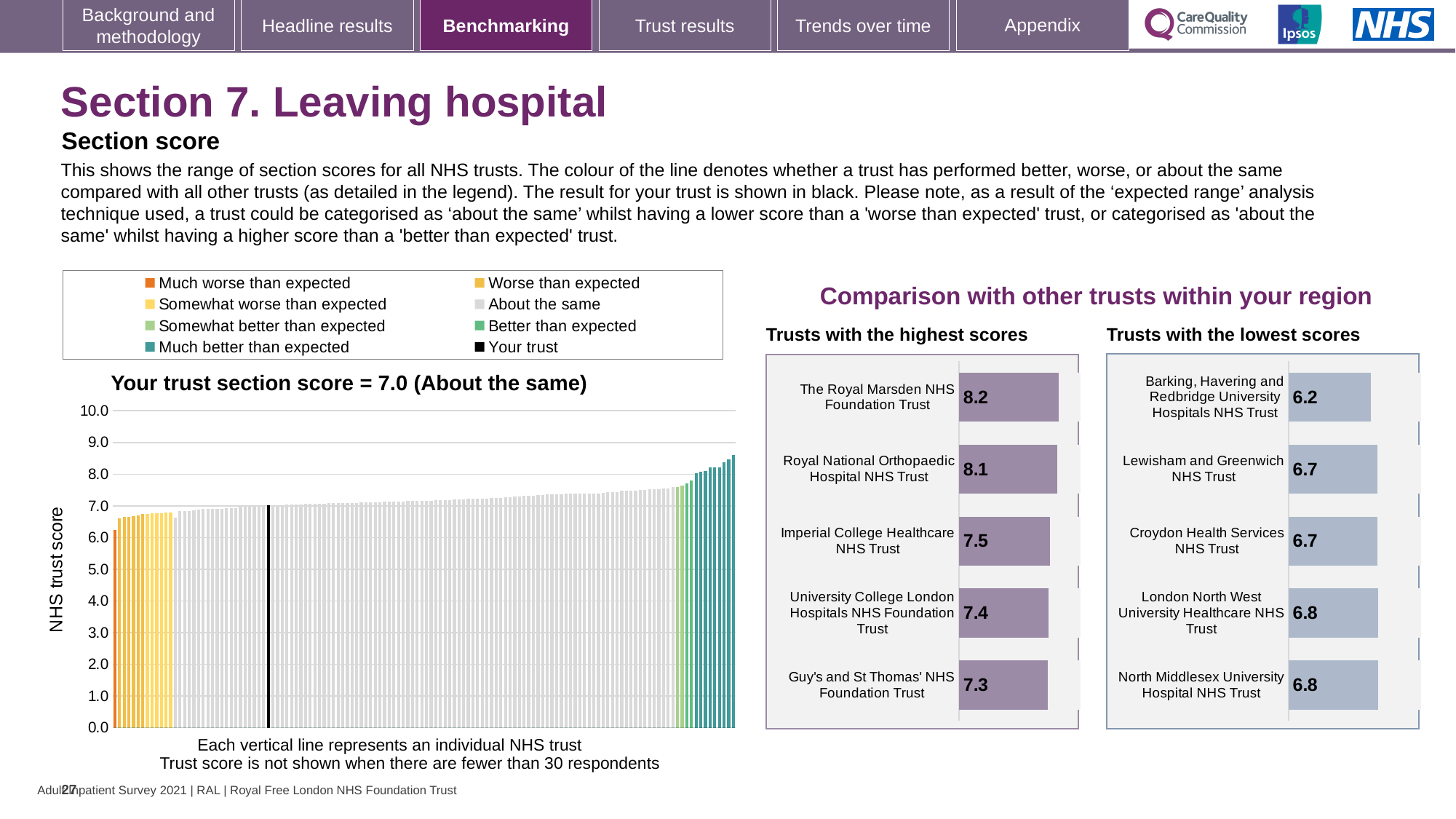
In the main chart on the left, is the value of the highest bar greater or less than 8.0? greater In the 'Trusts with the highest scores' chart, what is the score for Guy's and St Thomas' NHS Foundation Trust? 7.3 In the 'Trusts with the highest scores' chart, which trust has the highest score? The Royal Marsden NHS Foundation Trust In the main chart on the left, what is the section score for your trust? 7.0 How many entries does the legend above the main chart on the left list? 8 In the 'Trusts with the highest scores' chart, what is the difference between the scores of The Royal Marsden NHS Foundation Trust and Guy's and St Thomas' NHS Foundation Trust? 0.9 In the main chart on the left, do the bar values rise or fall from left to right along the x axis? rise In the 'Trusts with the lowest scores' chart, what is the score for Barking, Havering and Redbridge University Hospitals NHS Trust? 6.2 How many trusts are shown in the 'Trusts with the lowest scores' chart? 5 In the 'Trusts with the lowest scores' chart, which has the larger score: Lewisham and Greenwich NHS Trust or North Middlesex University Hospital NHS Trust? North Middlesex University Hospital NHS Trust In the 'Trusts with the lowest scores' chart, which trust has the lowest score? Barking, Havering and Redbridge University Hospitals NHS Trust In the 'Trusts with the highest scores' chart, what is the score for The Royal Marsden NHS Foundation Trust? 8.2